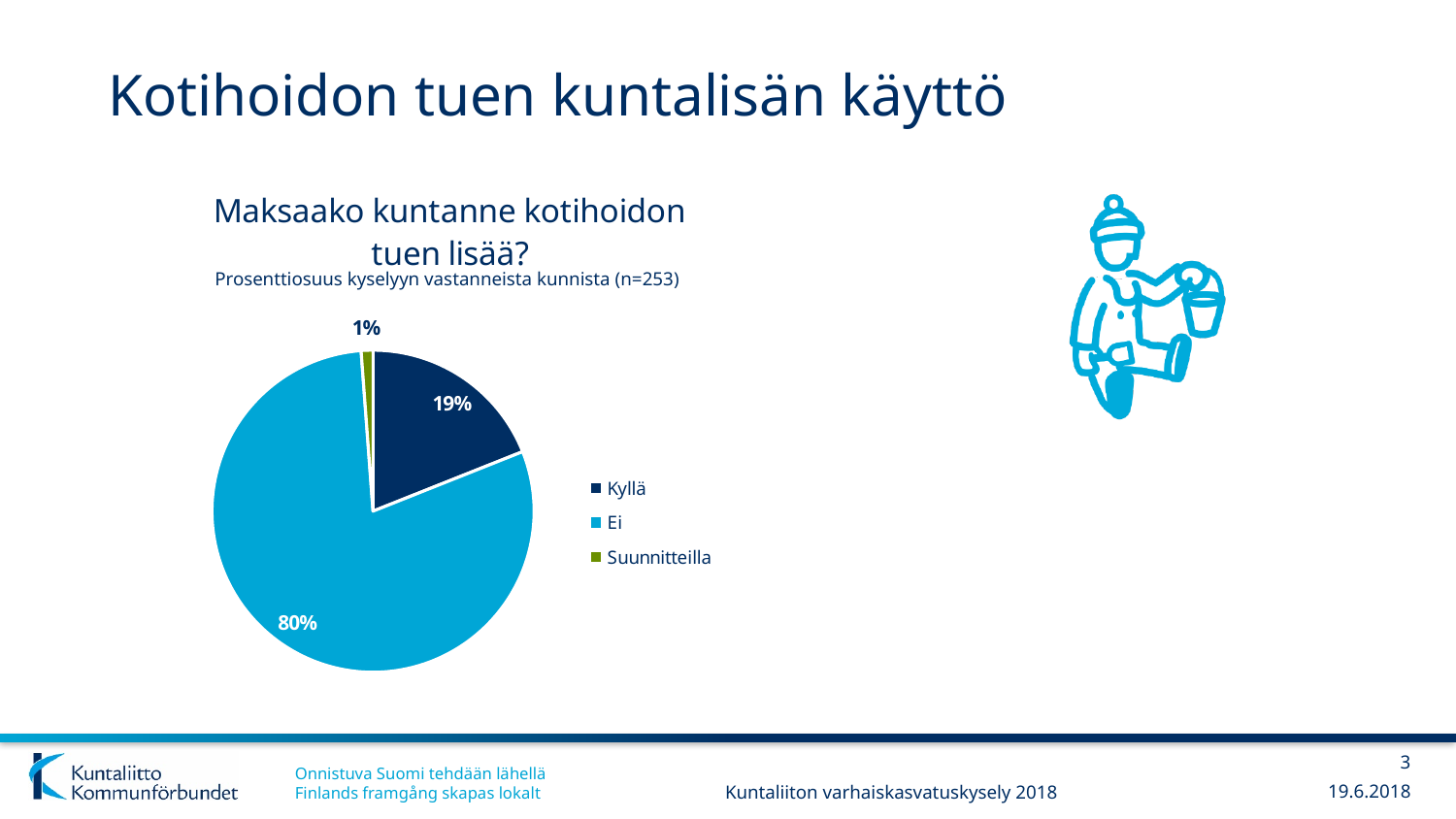
What percentage of the pie is labelled for "Kyllä"? 19% What percentage of the pie is labelled for "Suunnitteilla"? 1% What is the title of the pie chart? Maksaako kuntanne kotihoidon tuen lisää? Which category has the smallest share of the pie? Suunnitteilla Which category has the largest share of the pie? Ei How many entries does the legend list? 3 How many categories does the pie chart show? 3 What is the difference in percentage points between the "Ei" and "Kyllä" slices? 61 What percentage of the pie is labelled for "Ei"? 80% Which slice is larger, "Kyllä" or "Suunnitteilla"? Kyllä What kind of chart is shown on the slide? pie chart According to the chart subtitle, how many municipalities responded (n)? 253